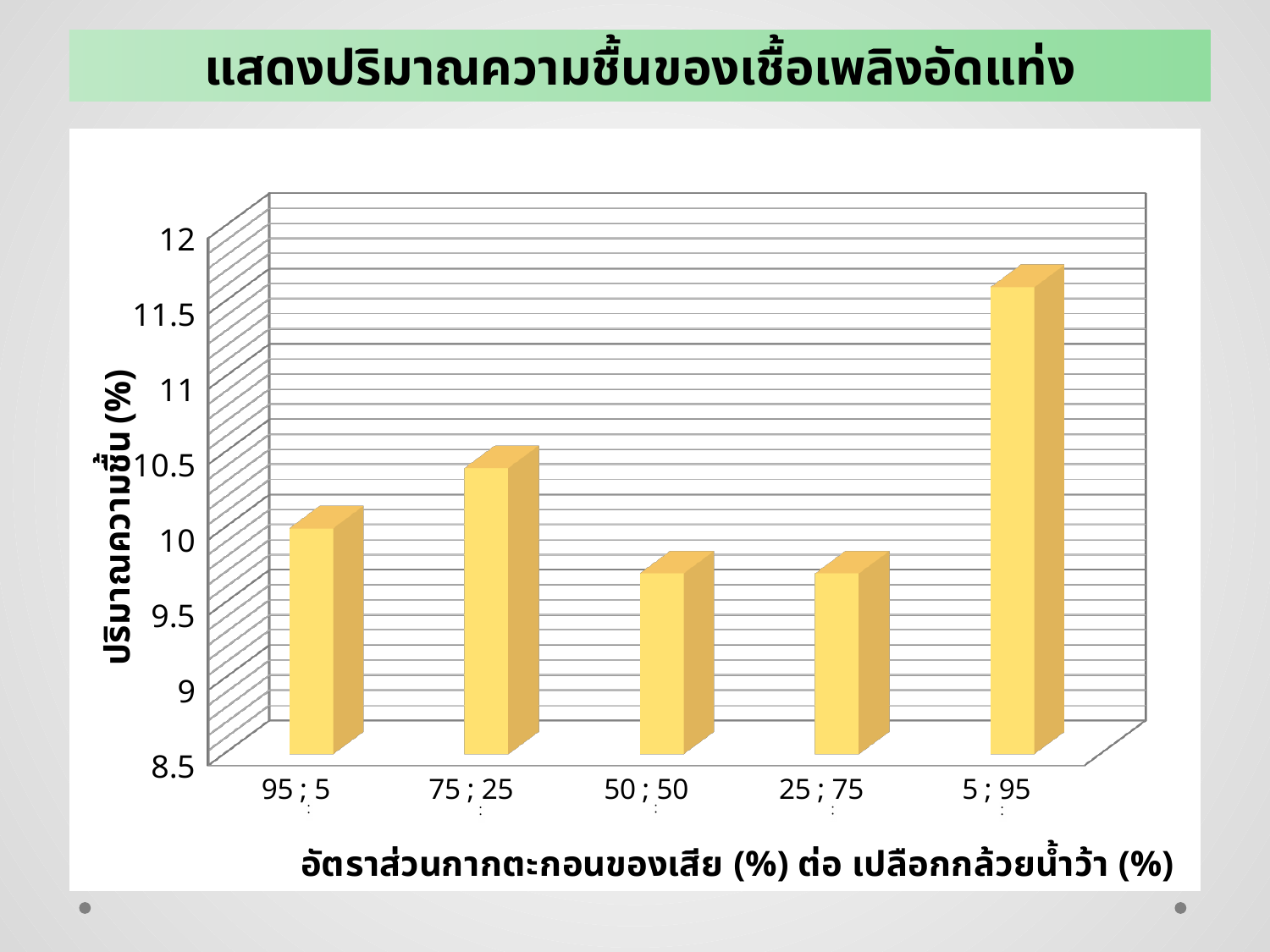
Is the value for 5 ; 95 greater or less than 11? greater Which category has the highest moisture content? 5 ; 95 Is the value for 75 ; 25 greater or less than 10? greater What kind of chart is shown on the slide? bar chart What colour are the bars in the chart? yellow Is the value for 50 ; 50 greater or less than 10? less What is the label of the y axis? ปริมาณความชื้น (%) How many categories are shown on the x axis? 5 Which is larger, the value for 5 ; 95 or the value for 95 ; 5? 5 ; 95 Which is larger, the value for 75 ; 25 or the value for 50 ; 50? 75 ; 25